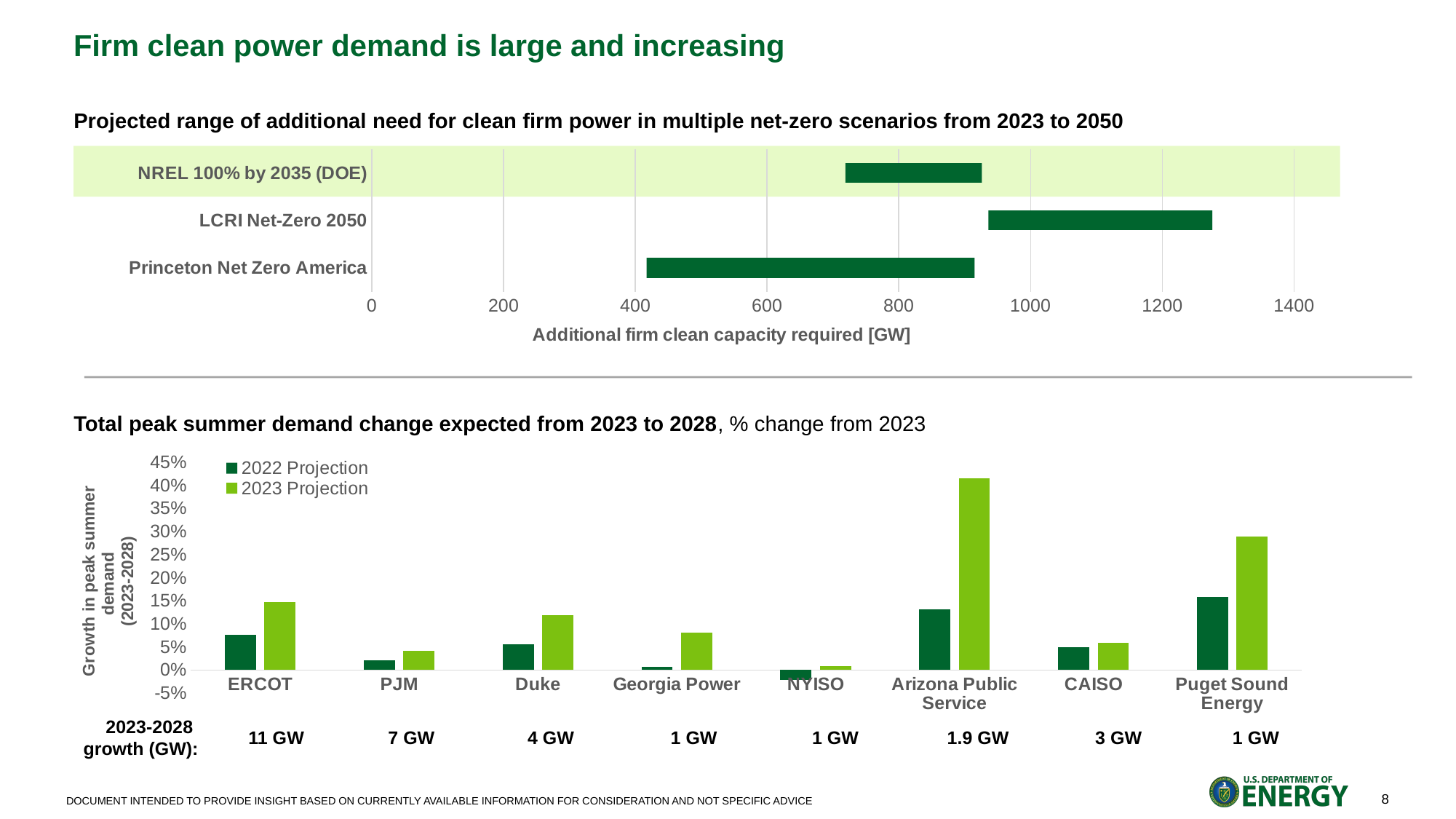
In the top chart, is the upper end of the LCRI Net-Zero 2050 range greater or less than 1200 GW? greater In the bottom chart, which region has the lowest 2022 Projection for growth in peak summer demand? NYISO In the bottom chart, is the 2023 Projection for Puget Sound Energy greater or less than 25%? greater What kind of chart is the top chart, 'Projected range of additional need for clean firm power in multiple net-zero scenarios from 2023 to 2050'? Bar chart How many series does the legend list in the bottom chart on total peak summer demand change? 2 How many scenarios are shown in the top chart on additional need for clean firm power? 3 In the top chart, which scenario has the lowest lower end of its range for additional firm clean capacity? Princeton Net Zero America In the top chart, which scenario has the highest upper end of its range for additional firm clean capacity? LCRI Net-Zero 2050 How many utilities or regions are shown on the x axis of the bottom chart on total peak summer demand change? 8 What is the x-axis title of the top chart? Additional firm clean capacity required [GW] In the top chart, is the lower end of the Princeton Net Zero America range greater or less than 600 GW? less In the bottom chart, which region has the highest 2023 Projection for growth in peak summer demand? Arizona Public Service